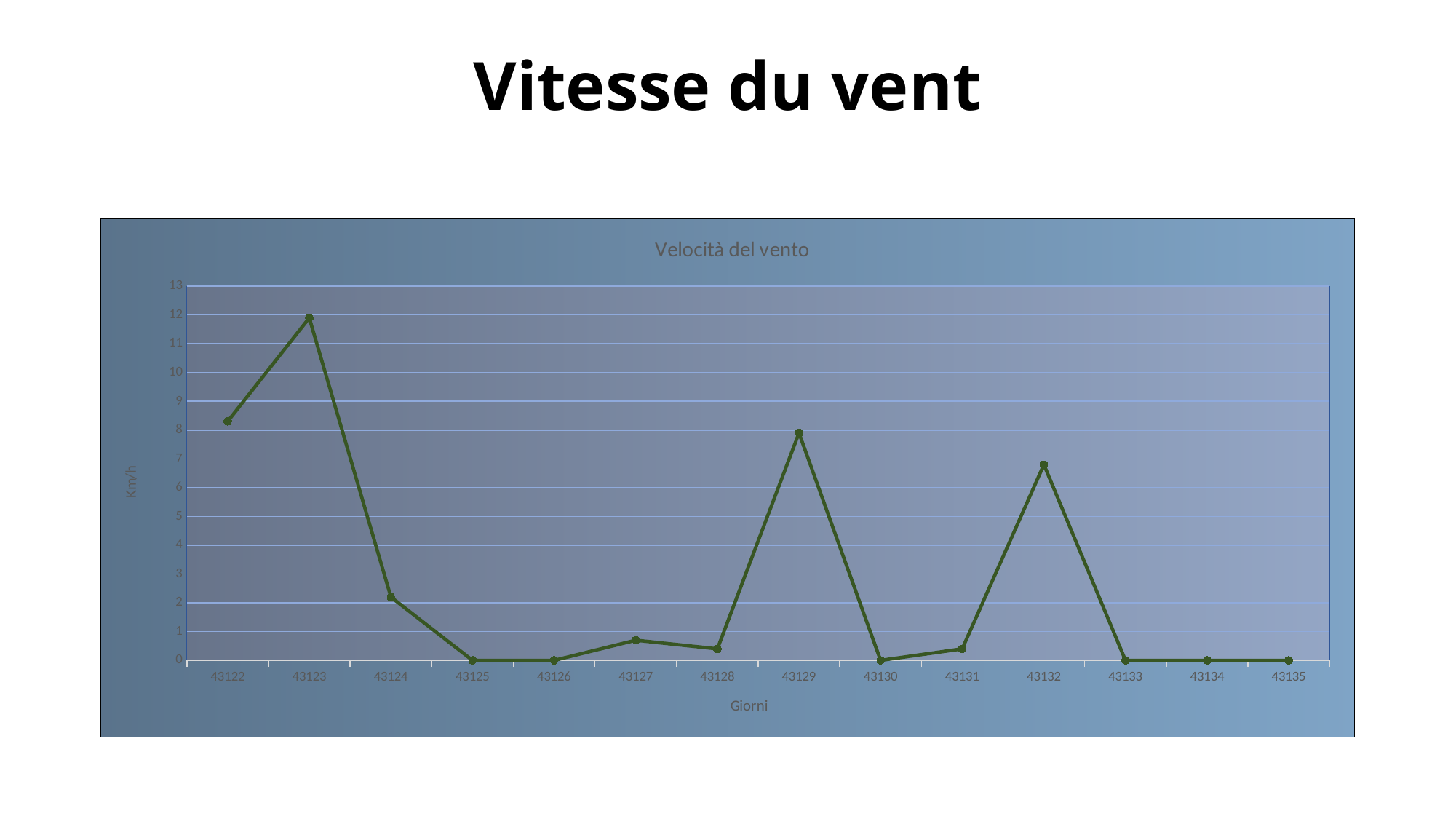
What is the title of the chart? Velocità del vento Is the value for 43132 greater or less than 7? less Do the values rise or fall from 43123 to 43125? fall Is the value for 43123 greater or less than 11? greater How many data points are plotted on the chart? 14 What is the value for 43125? 0 Is the value for 43124 greater or less than 3? less Which is larger, the value for 43129 or the value for 43132? 43129 Which day has the highest wind speed? 43123 What is the value for 43134? 0 What is the label of the vertical axis? Km/h What kind of chart is shown on the slide? line chart